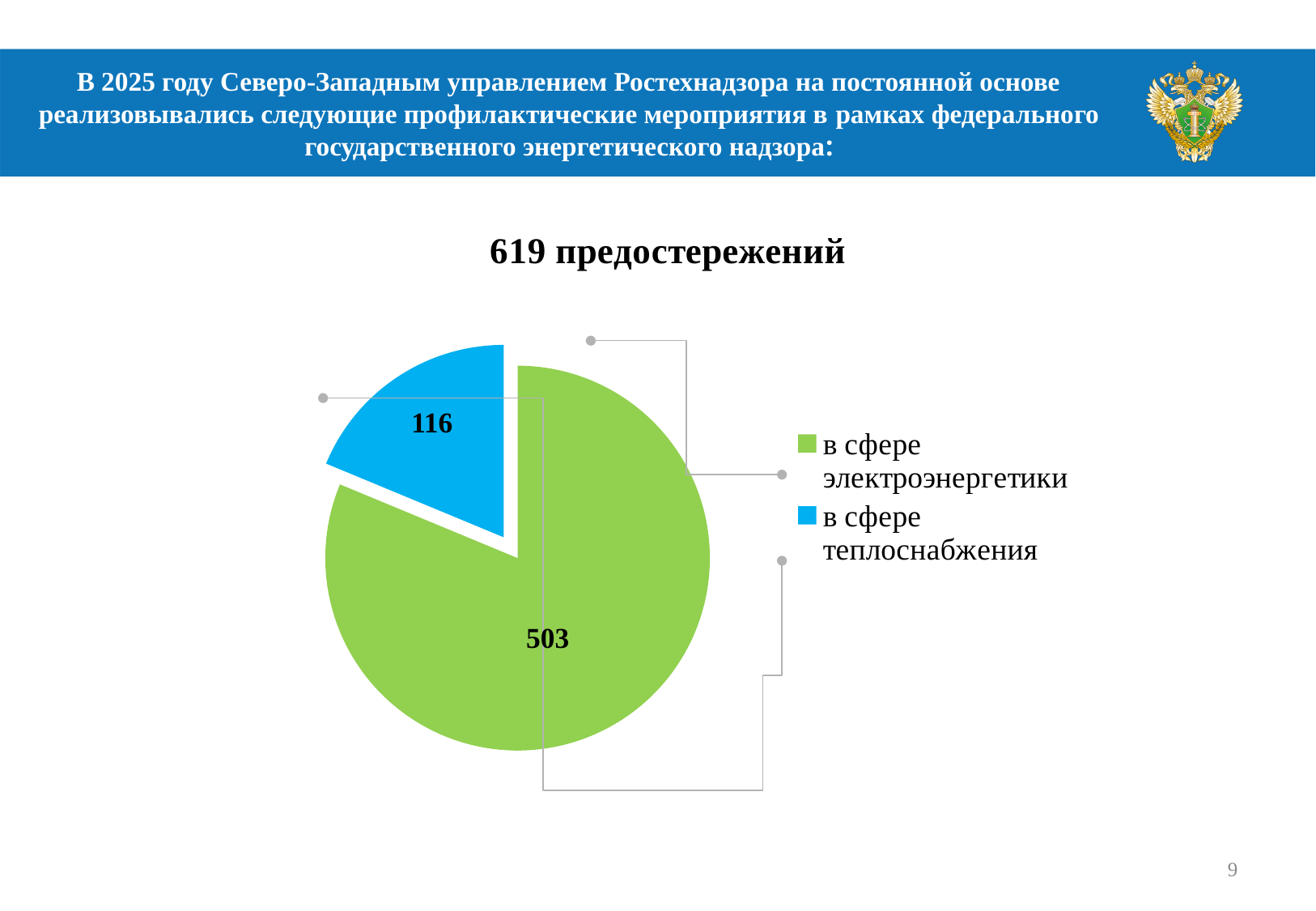
What is the total number of warnings shown in the chart title? 619 предостережений Which is larger: the value for electric power or the value for heat supply? в сфере электроэнергетики Which category has the smallest slice of the pie? в сфере теплоснабжения How many slices does the pie chart have? 2 What colour is the slice for electric power (в сфере электроэнергетики)? green What is the difference between the number of warnings in electric power and in heat supply? 387 How many warnings were issued in the sphere of heat supply (в сфере теплоснабжения)? 116 What colour is the slice for heat supply (в сфере теплоснабжения)? blue Which category has the largest slice of the pie? в сфере электроэнергетики What type of chart is shown on the slide? pie chart How many entries does the legend list? 2 How many warnings (предостережений) were issued in the sphere of electric power (в сфере электроэнергетики)? 503